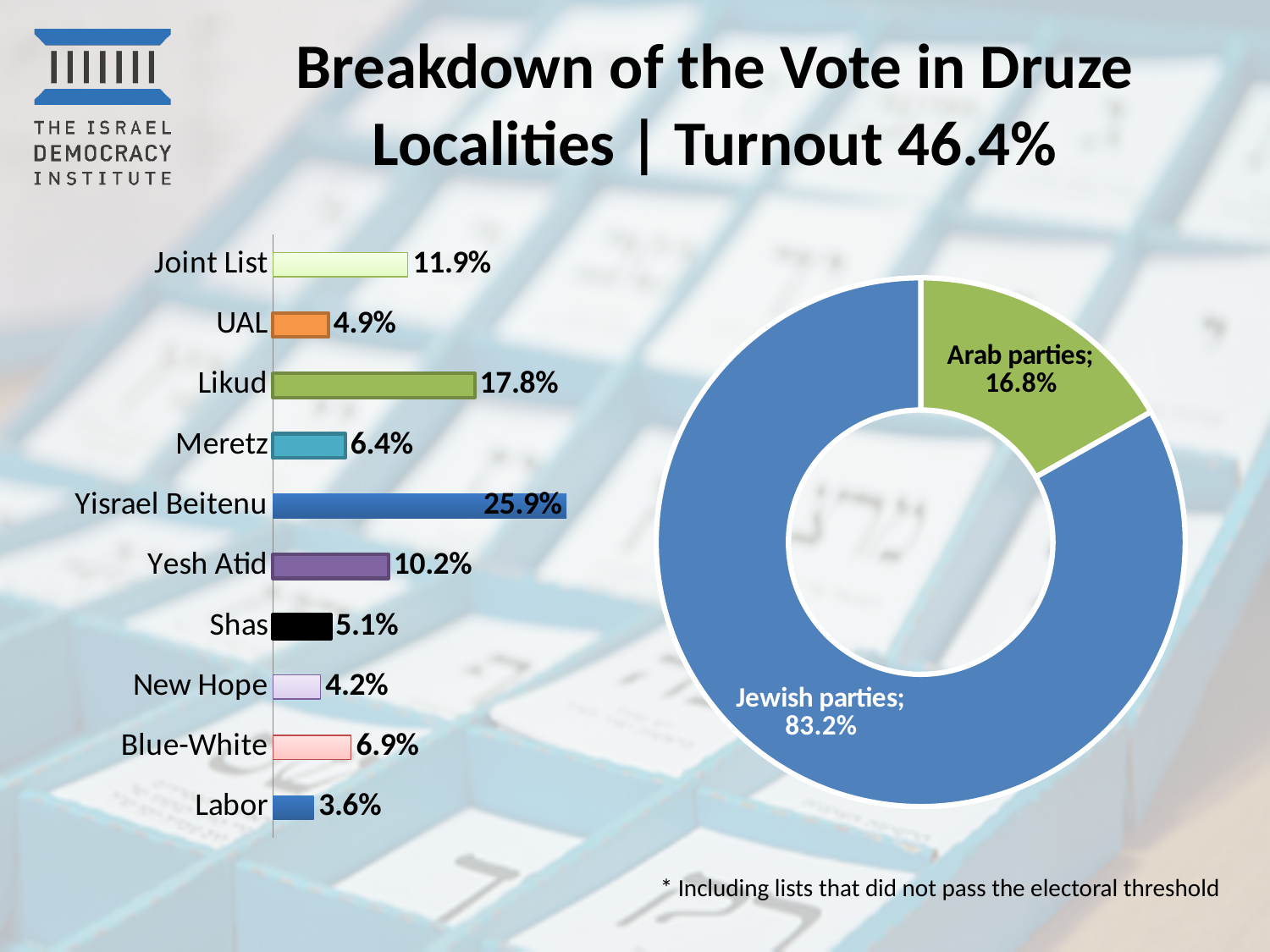
What kind of chart is on the left side of the slide? Bar chart In the doughnut chart on the right, what share of the vote went to Jewish parties? 83.2% In the bar chart on the left, which is larger, the value for Meretz or the value for Blue-White? Blue-White In the bar chart on the left, which party has the lowest value? Labor What is the turnout figure given in the slide title? 46.4% In the doughnut chart on the right, what share of the vote went to Arab parties? 16.8% In the bar chart on the left, what is the value for Likud? 17.8% In the bar chart on the left, which party has the highest value? Yisrael Beitenu In the bar chart on the left, what is the value for New Hope? 4.2% In the bar chart on the left, what is the difference between the values for Joint List and UAL? 7.0% In the bar chart on the left, what is the value for Yisrael Beitenu? 25.9% How many parties are shown in the bar chart on the left? 10